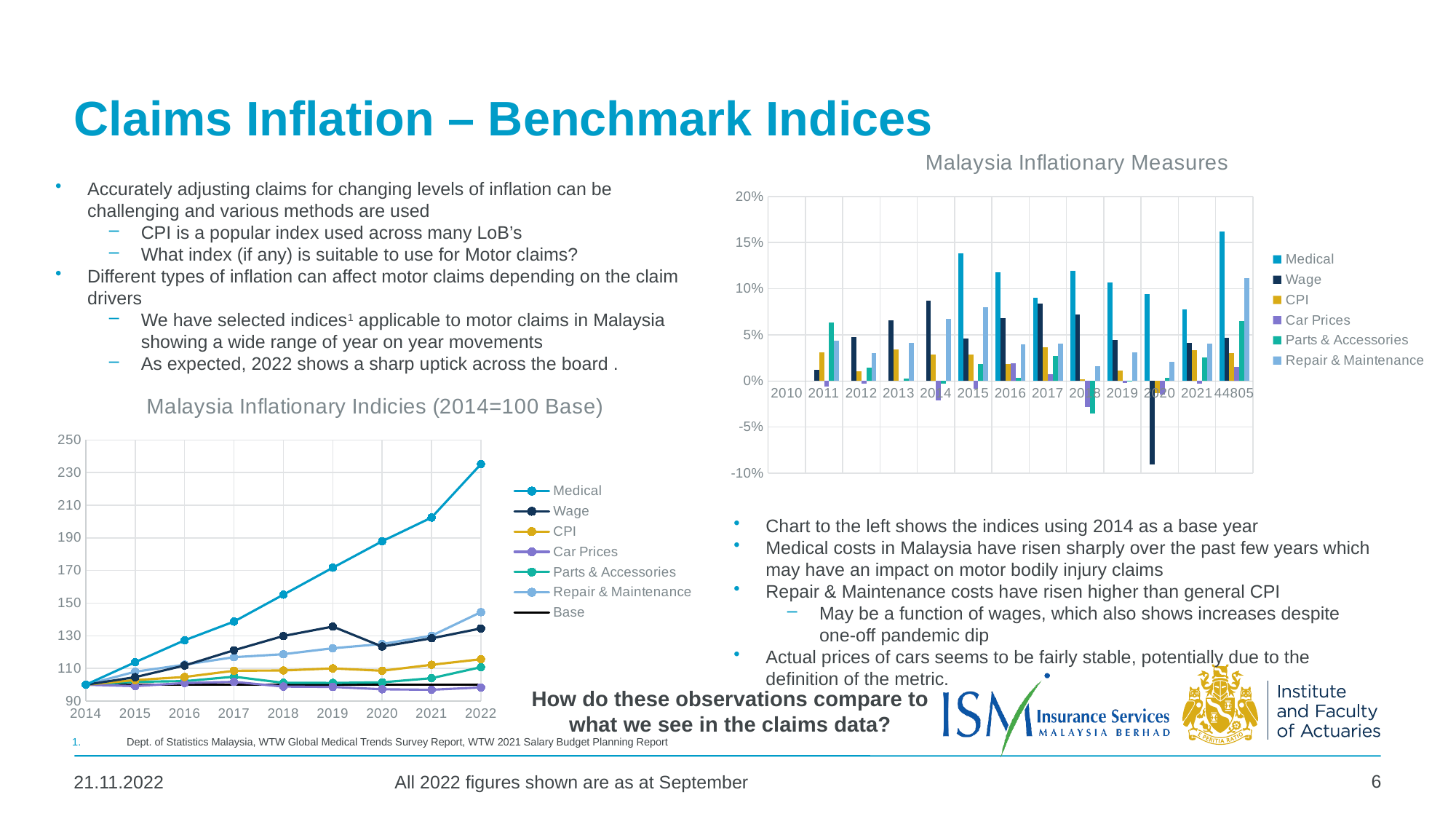
In the 'Malaysia Inflationary Indicies (2014=100 Base)' chart, does the Medical series rise or fall from 2014 to 2022? rise What type of chart is the 'Malaysia Inflationary Indicies (2014=100 Base)' chart? line chart In the 'Malaysia Inflationary Indicies (2014=100 Base)' chart, how many years are shown on the x axis? 9 How many series does the legend of the 'Malaysia Inflationary Indicies (2014=100 Base)' chart list? 7 In the 'Malaysia Inflationary Indicies (2014=100 Base)' chart, which series has the highest value in 2022? Medical In the 'Malaysia Inflationary Indicies (2014=100 Base)' chart, is the Medical value in 2022 greater or less than 210? greater What type of chart is the 'Malaysia Inflationary Measures' chart? bar chart In the 'Malaysia Inflationary Indicies (2014=100 Base)' chart, what is the value of the Base series in 2014? 100 In the 'Malaysia Inflationary Measures' chart, is the Wage value in 2020 greater or less than -5%? less In the 'Malaysia Inflationary Measures' chart, is the Medical value for 2015 larger or smaller than the Medical value for 2016? larger In the 'Malaysia Inflationary Indicies (2014=100 Base)' chart, is the Repair & Maintenance value in 2022 greater or less than 130? greater How many series does the legend of the 'Malaysia Inflationary Measures' chart list? 6